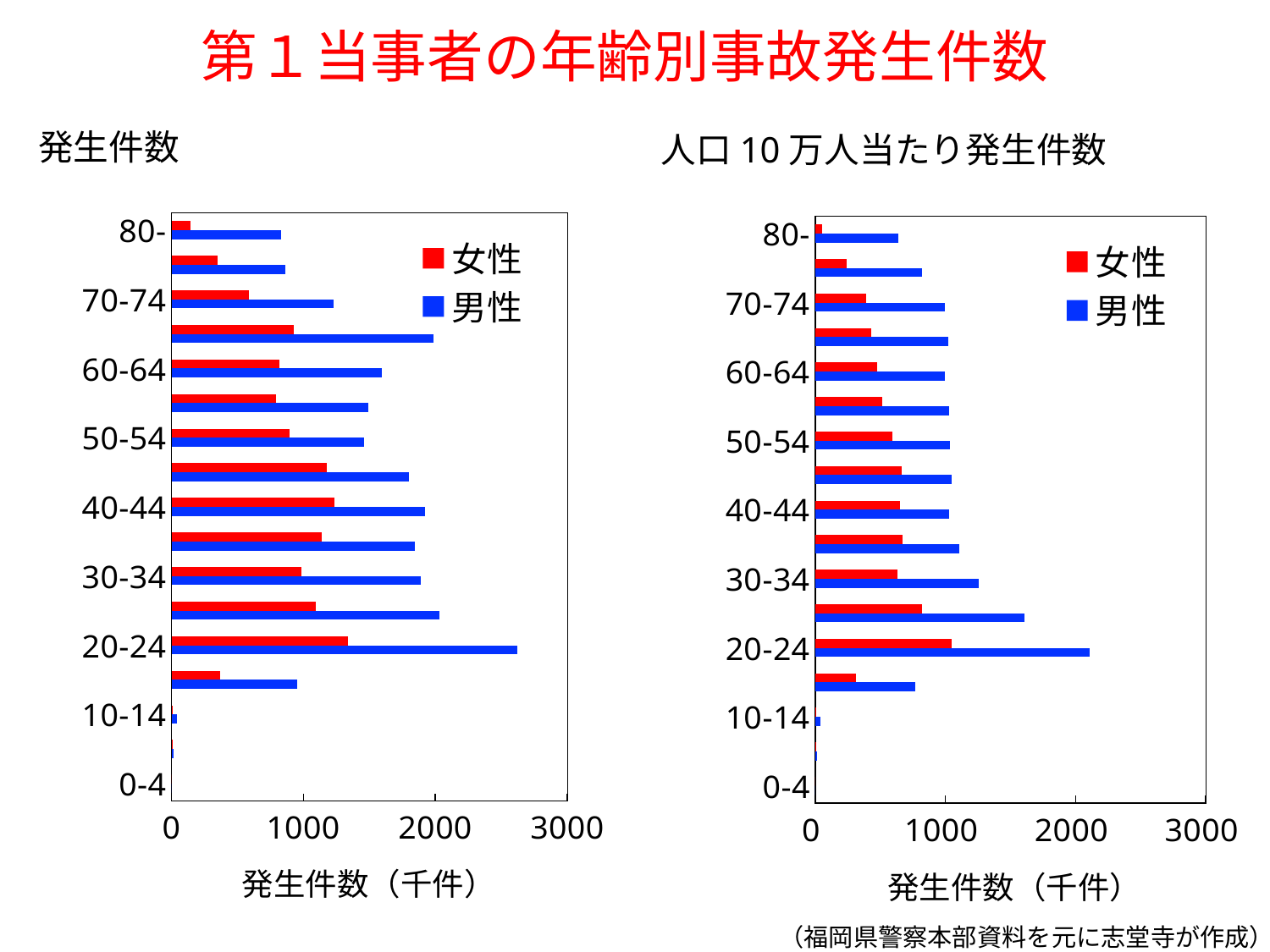
In the left chart (発生件数), is the 女性 value for 50-54 greater or less than 1000? less In the left chart (発生件数), is the 男性 value for 60-64 greater or less than 1000? greater In the left chart (発生件数), is the 男性 value for 20-24 greater or less than 2000? greater What is the x-axis title of the left chart (発生件数)? 発生件数（千件） In the left chart (発生件数), which age group has the highest value for 男性? 20-24 In the left chart (発生件数), which is larger for the 80- age group, 女性 or 男性? 男性 In the left chart (発生件数), which age group has the highest value for 女性? 20-24 What kind of chart is the left chart titled 発生件数? bar chart In the right chart (人口10万人当たり発生件数), which age group has the highest value for 男性? 20-24 How many series does the legend of the right chart (人口10万人当たり発生件数) list? 2